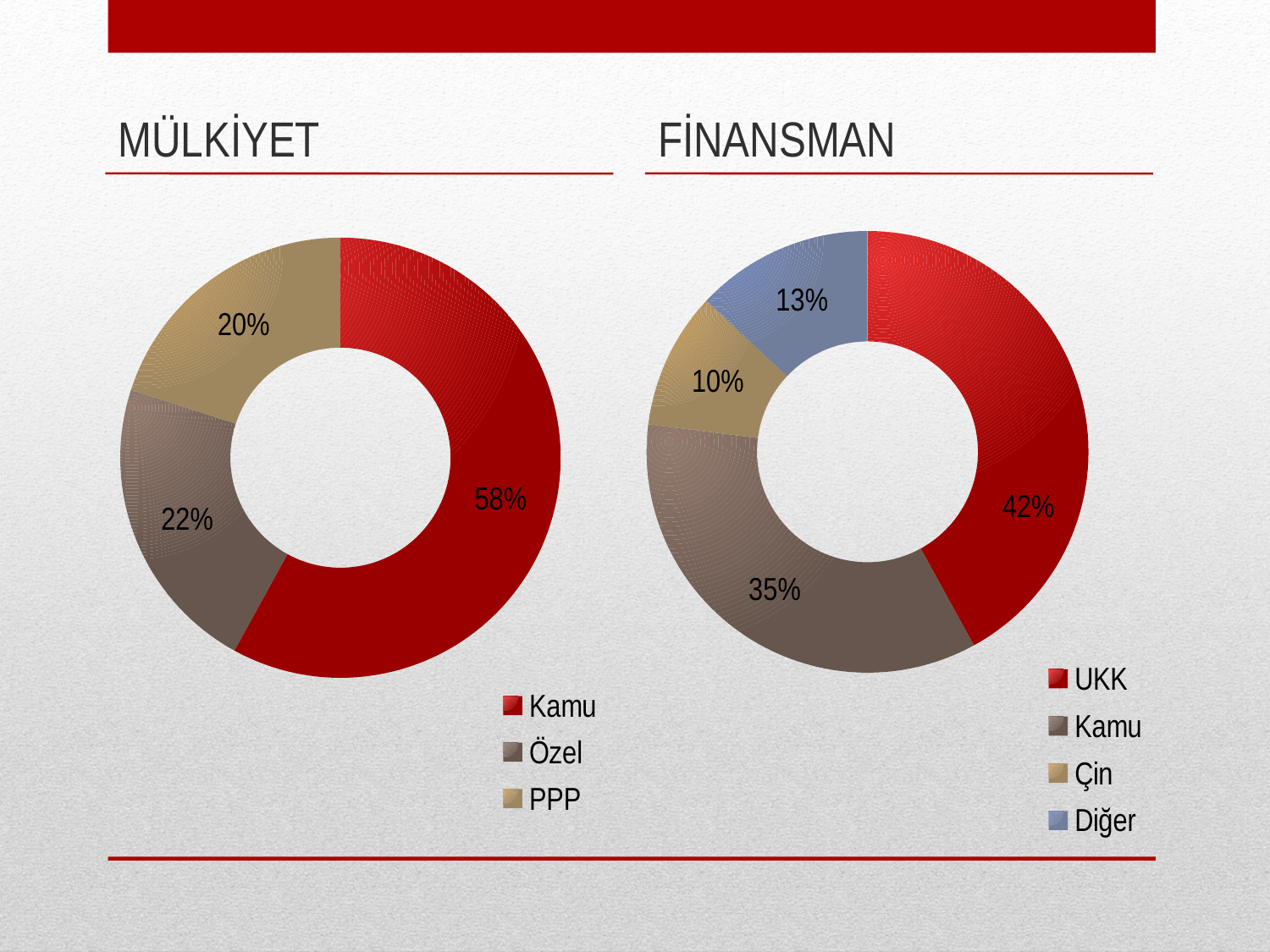
In the FİNANSMAN chart, what is the difference between the UKK and Kamu shares? 7% In the FİNANSMAN chart, which category has the smallest share? Çin In the FİNANSMAN chart, which is larger, Kamu or Diğer? Kamu In the FİNANSMAN chart, how many categories does the legend list? 4 In the FİNANSMAN chart, what share does Çin have? 10% In the MÜLKİYET chart, what is the difference between the Kamu and Özel shares? 36% In the MÜLKİYET chart, how many categories does the legend list? 3 In the MÜLKİYET chart, what share does Kamu have? 58% What type of chart is used for the MÜLKİYET chart? Doughnut (pie) chart In the FİNANSMAN chart, what share does UKK have? 42% In the MÜLKİYET chart, what share does PPP have? 20% In the MÜLKİYET chart, which category has the largest share? Kamu